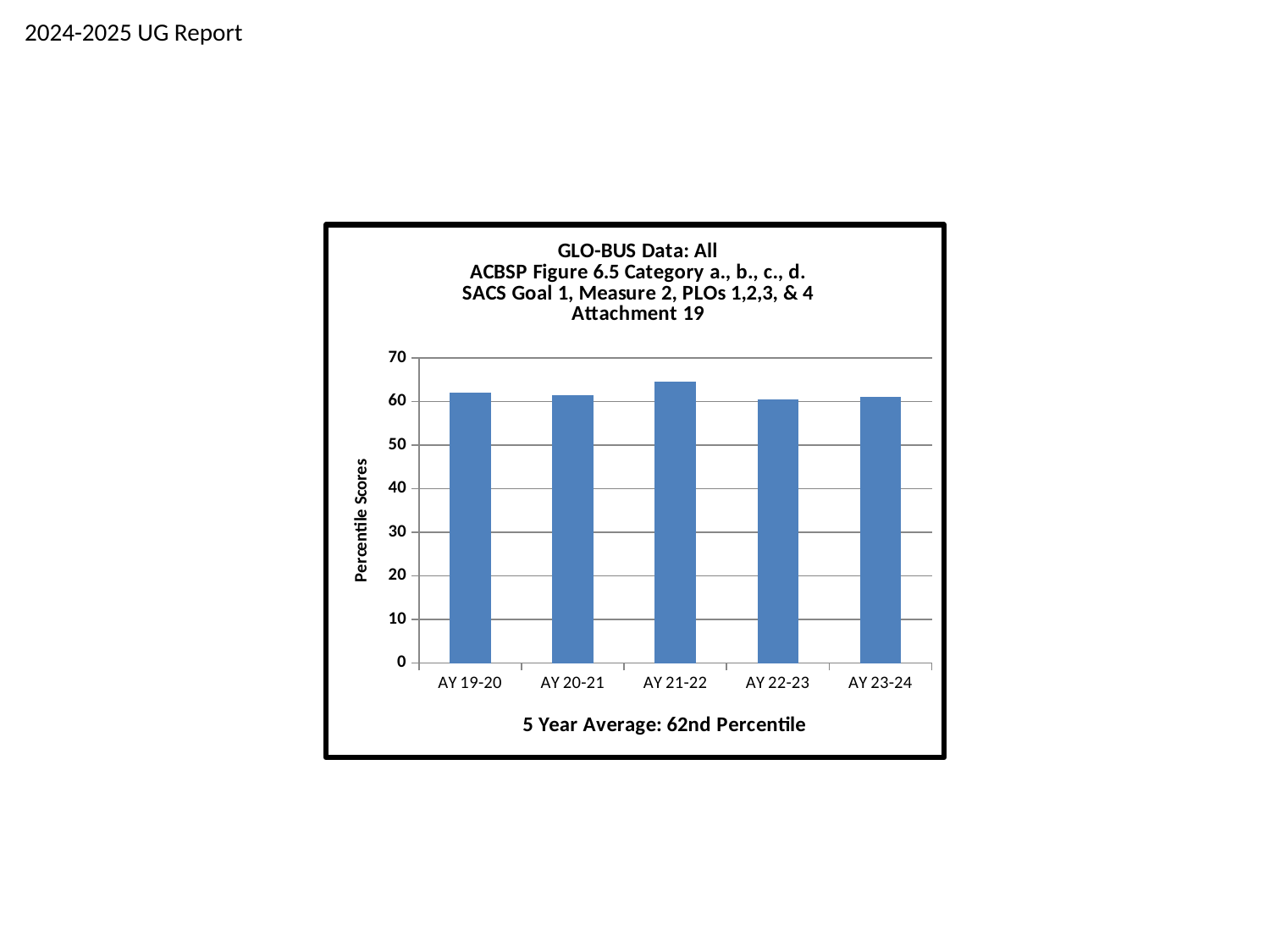
How many academic years are plotted on the chart? 5 Is the value for AY 19-20 greater or less than 50? greater What 5 year average is stated below the horizontal axis of the chart? 62nd Percentile What kind of chart is shown on the slide? bar chart Which is larger, the value for AY 21-22 or the value for AY 20-21? AY 21-22 Is the value for AY 21-22 greater or less than 60? greater Is the value for AY 22-23 greater or less than 70? less Which academic year has the highest percentile score? AY 21-22 Which is larger, the value for AY 21-22 or the value for AY 22-23? AY 21-22 What is the label on the vertical axis of the chart? Percentile Scores